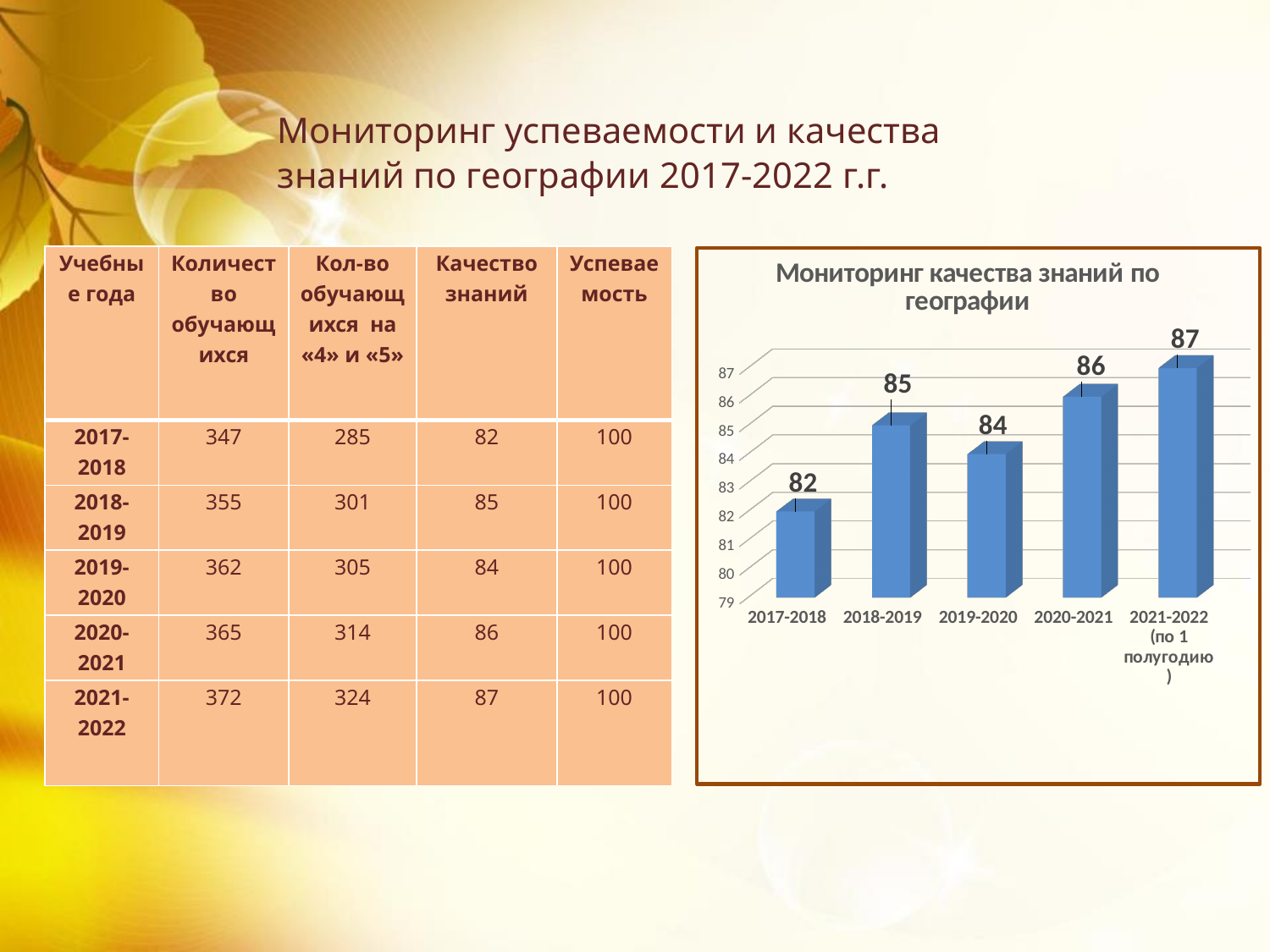
How many categories are shown on the x axis of the chart? 5 Do the values generally rise or fall from 2017-2018 to 2021-2022? rise Which category has the highest value in the chart? 2021-2022 (по 1 полугодию) What kind of chart is shown on the slide? bar chart What is the title of the chart? Мониторинг качества знаний по географии Is the value for 2020-2021 greater or less than 84? greater What is the value for 2021-2022 (по 1 полугодию) in the chart? 87 What is the value for 2017-2018 in the chart? 82 What is the difference between the values for 2021-2022 (по 1 полугодию) and 2017-2018? 5 Which category has the lowest value in the chart? 2017-2018 Which is larger, the value for 2018-2019 or the value for 2019-2020? 2018-2019 What is the value for 2019-2020 in the chart? 84